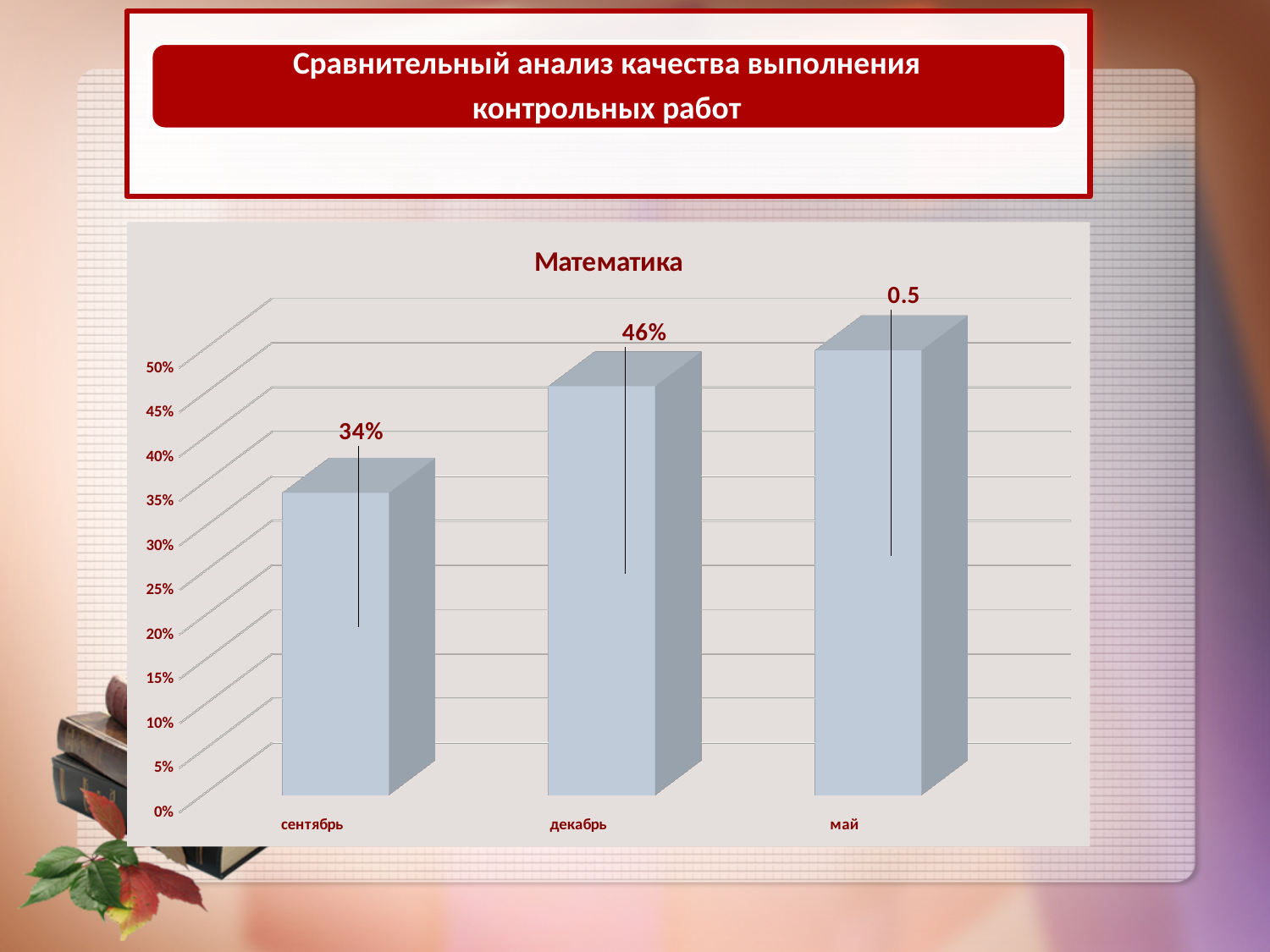
What is the difference between the values for декабрь and сентябрь? 12% Which category has the highest bar in the chart? май How many categories are shown on the x axis of the chart? 3 Do the values rise or fall from сентябрь to май? rise What data label is shown above the bar for май? 0.5 Is the value for сентябрь greater or less than 40%? less What is the value for сентябрь in the Математика chart? 34% Which is larger, the value for сентябрь or the value for декабрь? декабрь Which category has the lowest bar in the chart? сентябрь What is the title of the chart? Математика What kind of chart is shown on the slide? bar chart What is the value for декабрь in the Математика chart? 46%